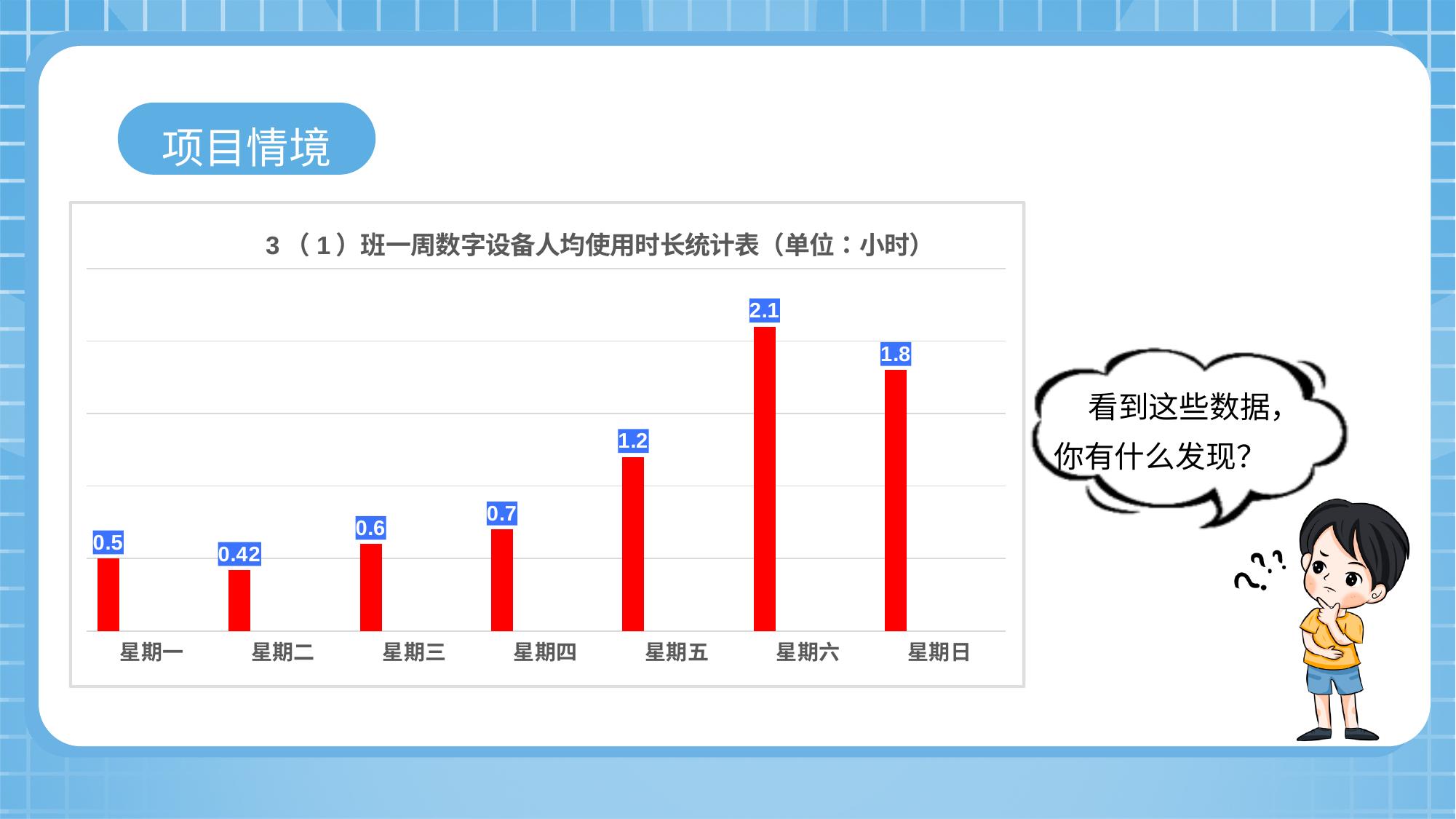
How many days are shown on the x axis? 7 What is the difference between the values for 星期五 and 星期四? 0.5 Which day has the lowest value? 星期二 What unit is given in the chart title? 小时 Which day has the highest value? 星期六 What is the value for 星期六? 2.1 What kind of chart is this? bar chart Which is larger, the value for 星期三 or the value for 星期四? 星期四 What is the difference between the values for 星期六 and 星期日? 0.3 What is the value for 星期五? 1.2 Do the values rise or fall from 星期一 to 星期六? rise What is the value for 星期二? 0.42